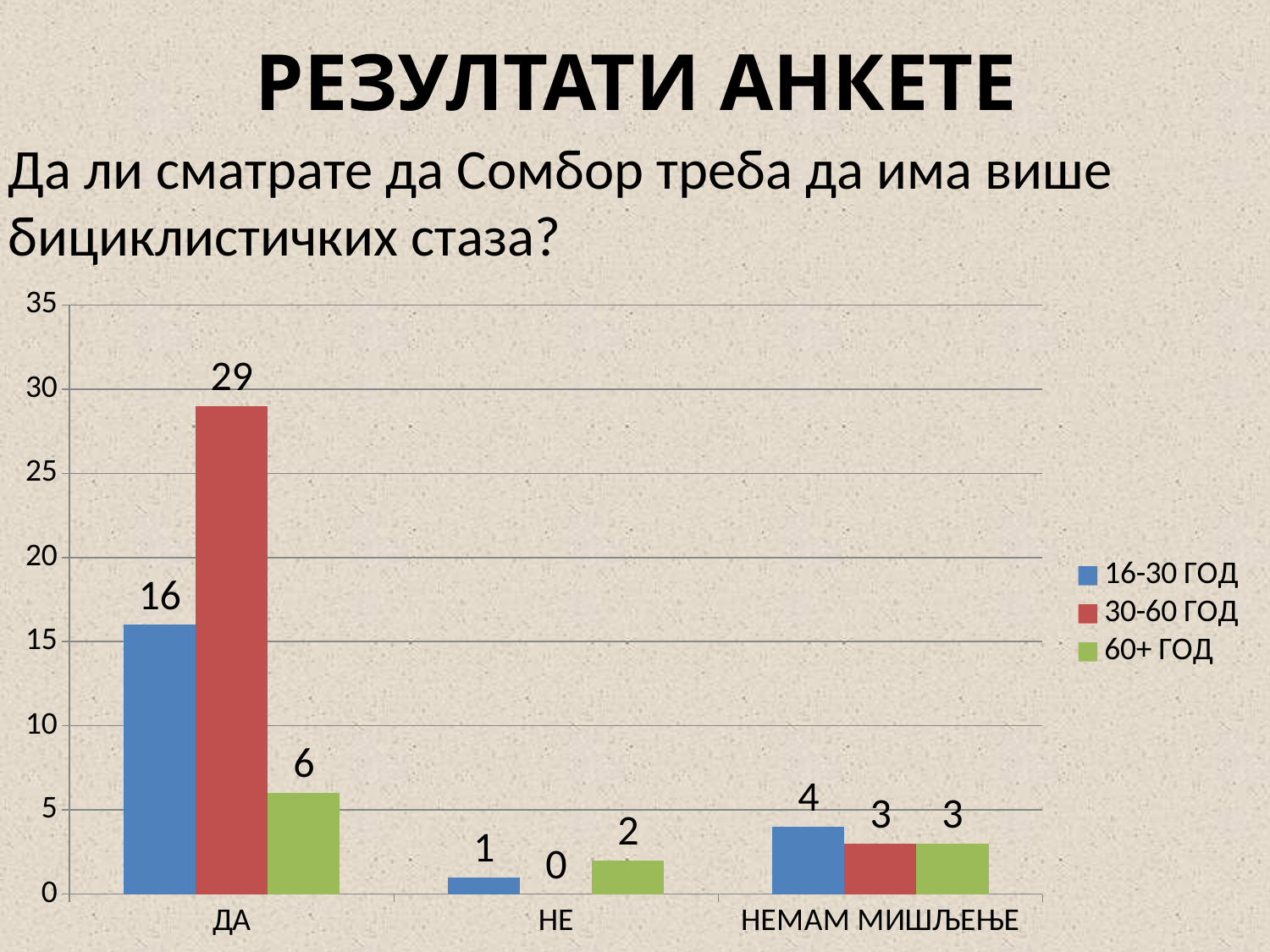
What kind of chart is shown on the slide? Bar chart How many series does the legend list? 3 What is the value for the 30-60 ГОД series in the ДА category? 29 Which series has the highest value in the ДА category? 30-60 ГОД What is the value for the 16-30 ГОД series in the НЕМАМ МИШЉЕЊЕ category? 4 Which is larger: the 60+ ГОД value for ДА or the 60+ ГОД value for НЕМАМ МИШЉЕЊЕ? ДА What is the difference between the 30-60 ГОД and 16-30 ГОД values in the ДА category? 13 What is the value for the 60+ ГОД series in the НЕ category? 2 What is the value for the 30-60 ГОД series in the НЕ category? 0 How many categories are shown on the x axis? 3 What is the value for the 16-30 ГОД series in the ДА category? 16 Which series has the lowest value in the НЕ category? 30-60 ГОД